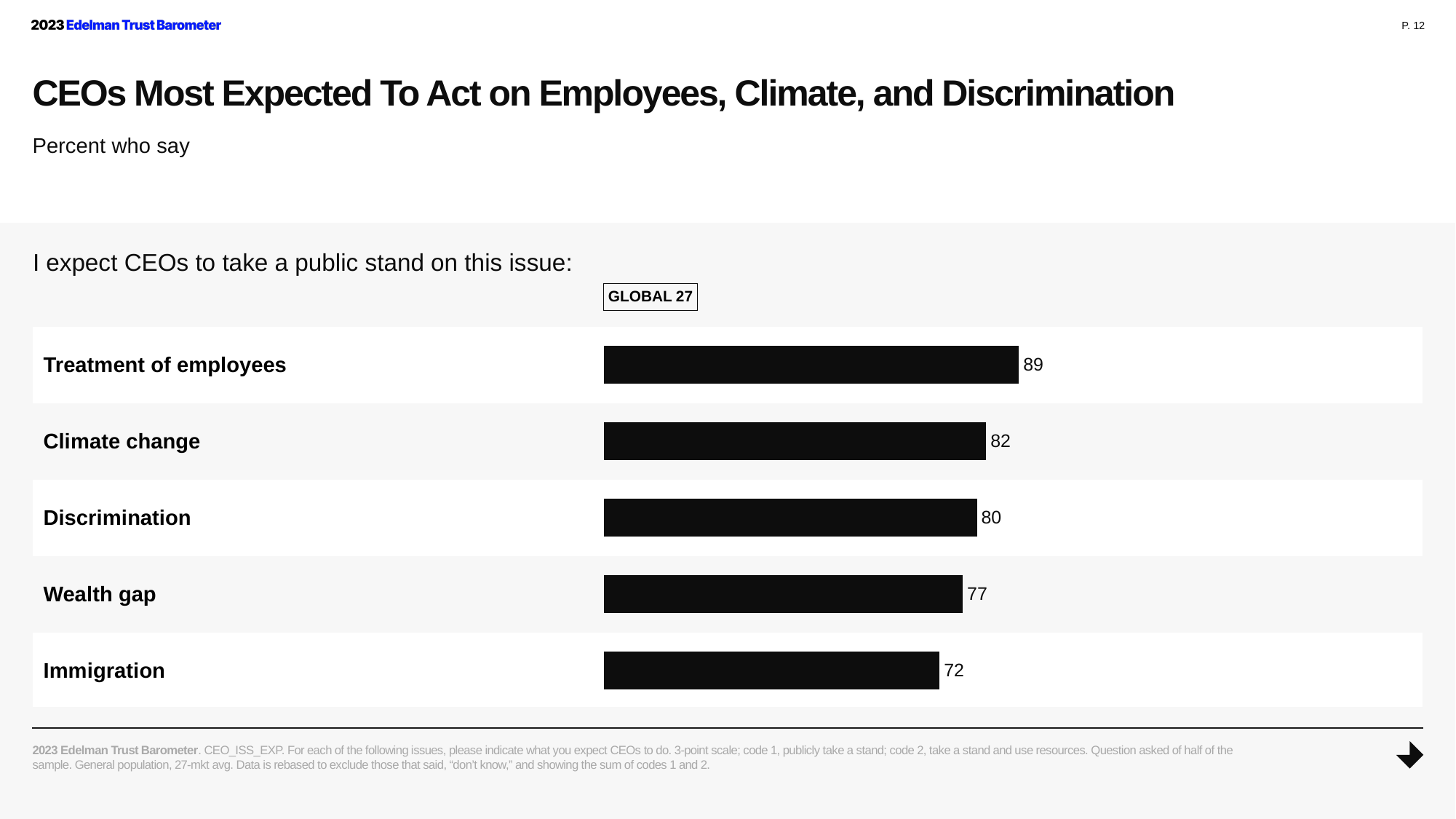
What is the difference between the values for Climate change and Wealth gap? 5 What is the value for Climate change? 82 What is the value for Immigration? 72 What is the value for Discrimination? 80 What is the difference between the values for Treatment of employees and Immigration? 17 What kind of chart is shown on the slide? Bar chart What is the value for Treatment of employees? 89 Which is larger, the value for Discrimination or the value for Wealth gap? Discrimination What is the value for Wealth gap? 77 Which issue has the highest value? Treatment of employees How many issues are shown in the chart? 5 Which issue has the lowest value? Immigration